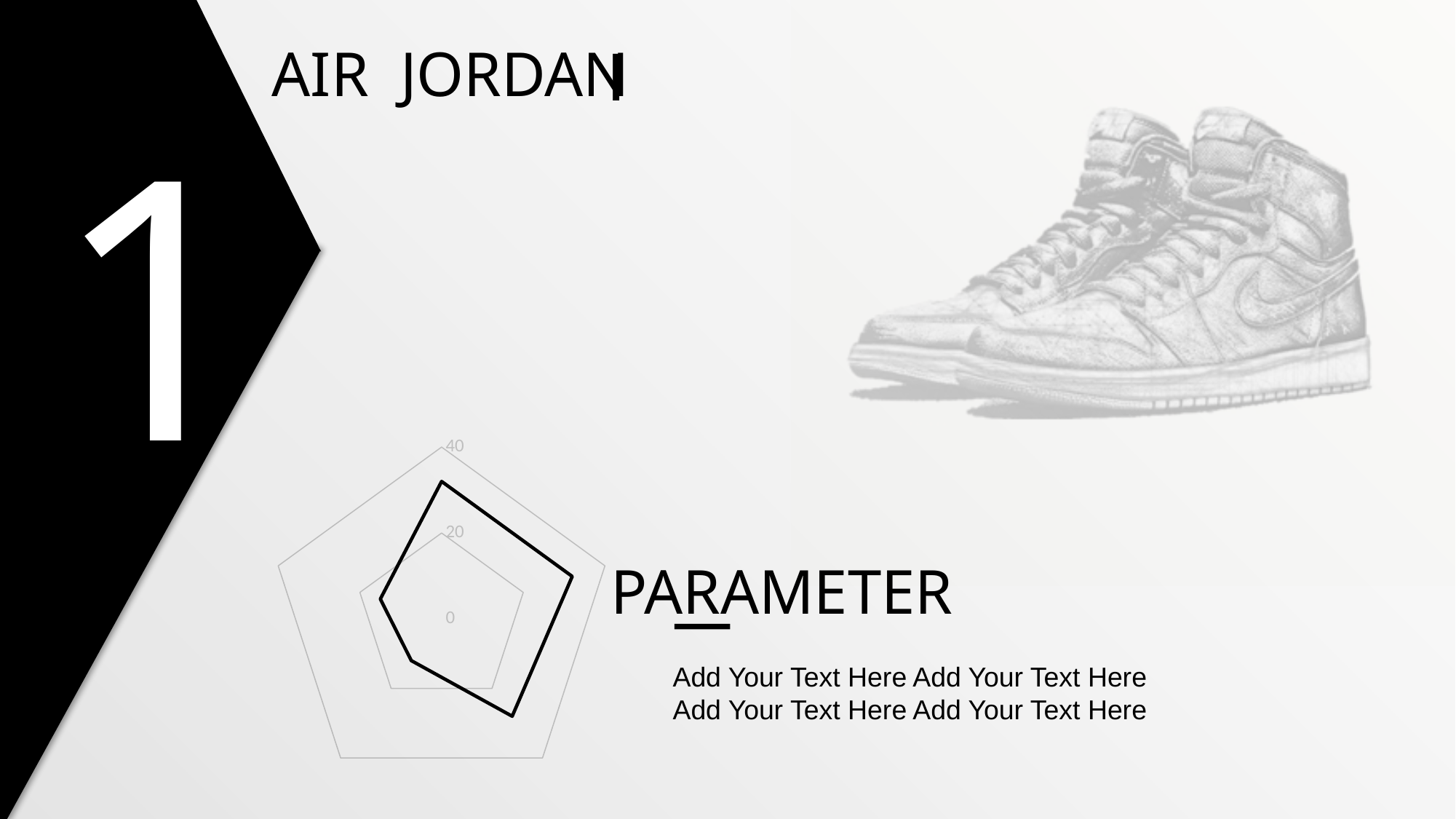
How many axes (points) does the radar chart have? 5 Is the value at the bottom-right vertex of the radar chart greater or less than 40? less Is the value at the top vertex of the radar chart greater or less than 20? greater Is the value at the bottom-right vertex of the radar chart greater or less than 20? greater What kind of chart is shown on the slide? radar chart Which is larger on the radar chart: the value at the top vertex or the value at the bottom-left vertex? top vertex How many data series are plotted on the radar chart? 1 What is the highest axis tick value shown on the radar chart? 40